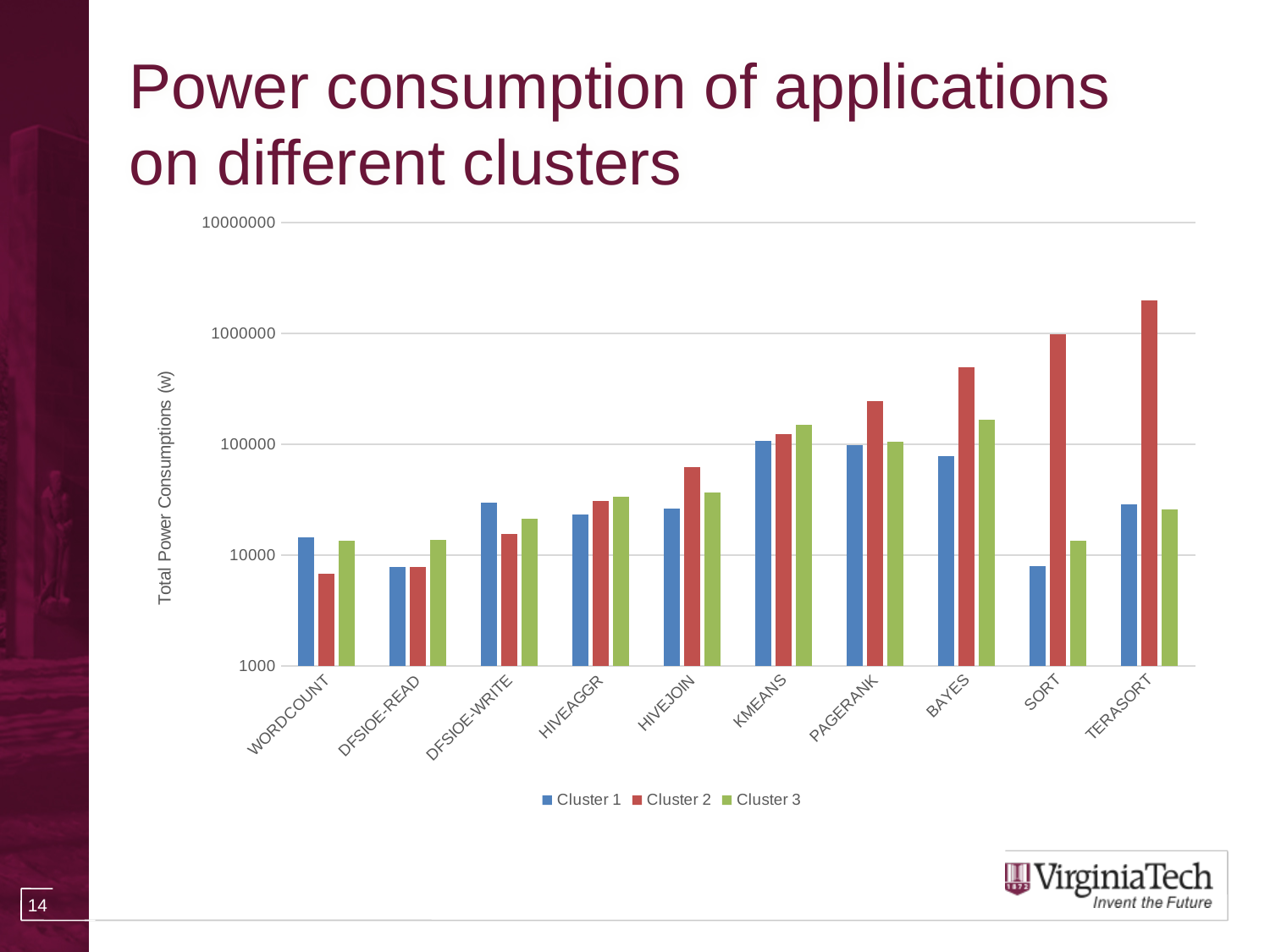
Which application has the lowest Cluster 2 power consumption? WORDCOUNT How many applications are shown along the x axis of the chart? 10 For SORT, which is larger: the Cluster 1 value or the Cluster 2 value? Cluster 2 How many series does the chart's legend list? 3 Is the Cluster 2 value for TERASORT greater or less than 1000000? greater Is the Cluster 2 value for BAYES greater or less than 100000? greater Is the Cluster 1 value for SORT greater or less than 10000? less Which application has the highest Cluster 2 power consumption? TERASORT For WORDCOUNT, which is larger: the Cluster 1 value or the Cluster 2 value? Cluster 1 What is the label of the chart's y axis? Total Power Consumptions (w) What kind of chart is shown on the slide? bar chart